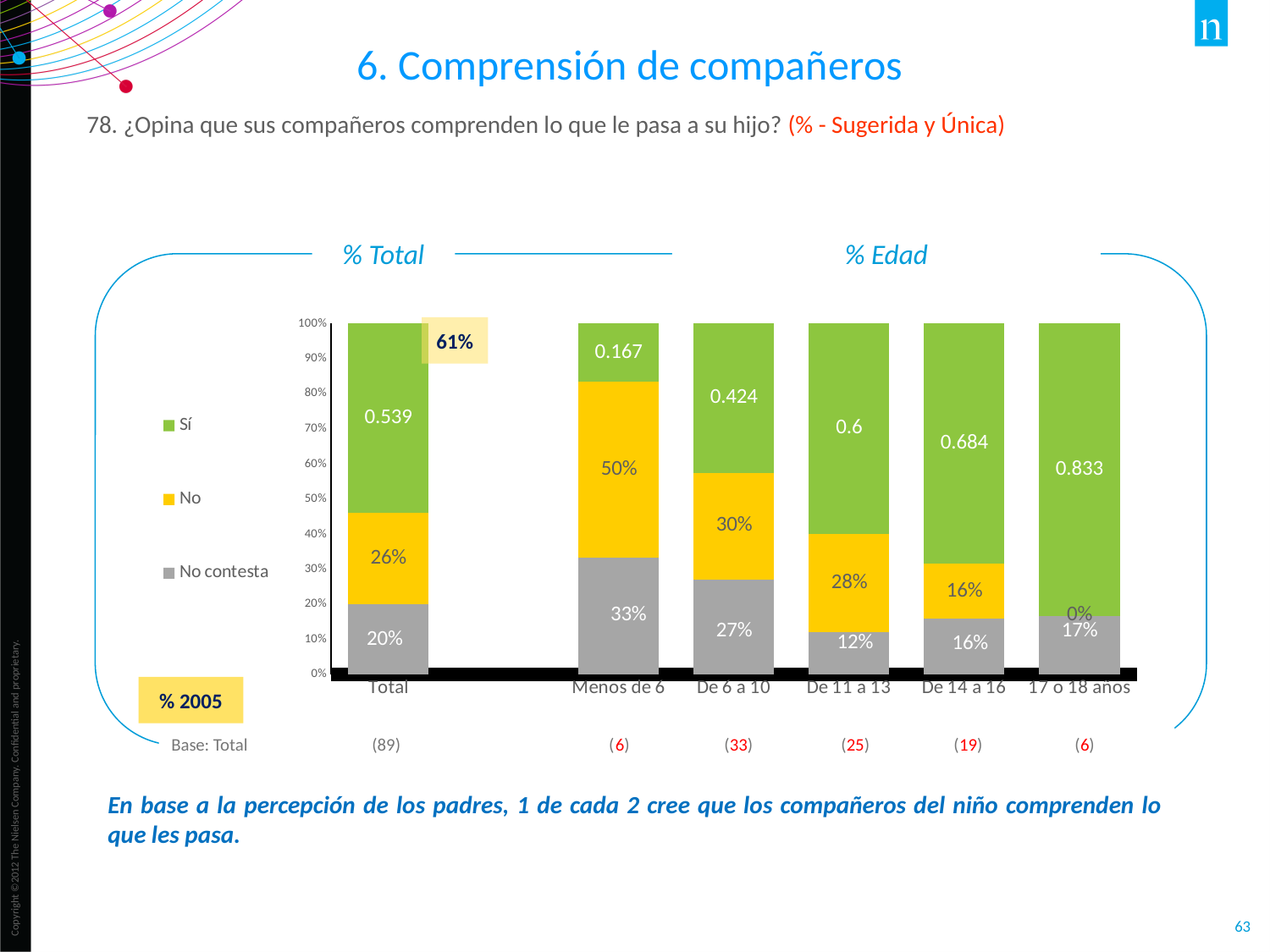
What is the value of the 'No' segment for 'Menos de 6'? 50% What is the value of the 'Sí' segment for '17 o 18 años'? 0.833 How many series does the legend list? 3 Which is larger, the 'No contesta' value for 'Menos de 6' or for 'De 14 a 16'? Menos de 6 Which series is shown in green in the legend? Sí What is the value of the 'Sí' segment for the 'Total' bar? 0.539 Which category has the highest 'Sí' value? 17 o 18 años What kind of chart is shown on the slide? stacked bar chart Which category has the lowest 'No contesta' value? De 11 a 13 How many categories are shown on the x axis of the chart? 6 What is the value of the 'No contesta' segment for 'De 6 a 10'? 27% What is the difference between the 'No' values for 'Menos de 6' and 'De 11 a 13'? 22%